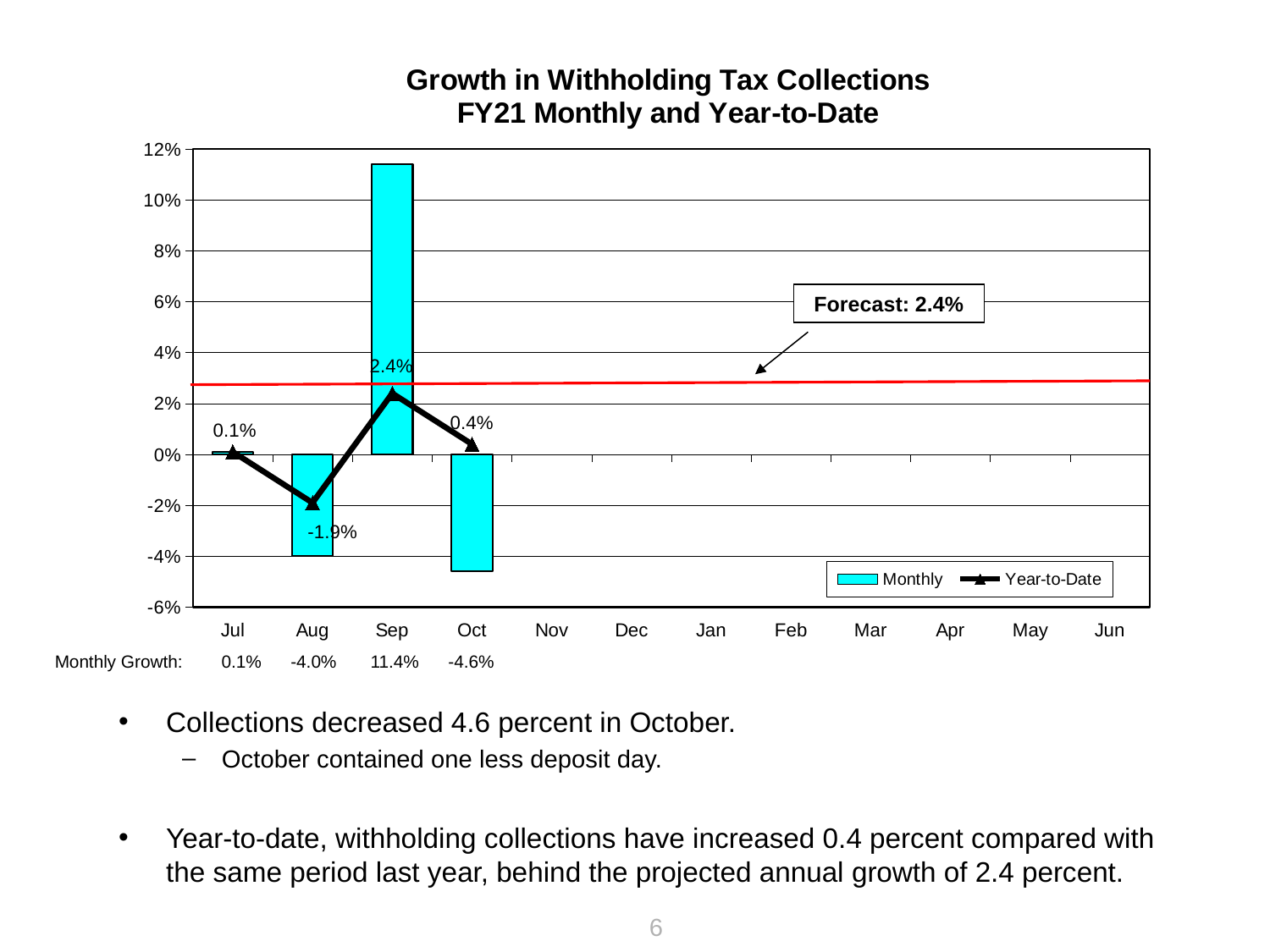
What is the Monthly growth value for Oct? -4.6% Which month has the lowest Monthly growth value? Oct How many series does the legend list? 2 What is the Year-to-Date value for Aug? -1.9% Which month has the highest Monthly growth value? Sep What is the Year-to-Date value for Oct? 0.4% Is the Monthly growth value for Sep greater or less than 10%? greater What is the title of the chart? Growth in Withholding Tax Collections FY21 Monthly and Year-to-Date What is the difference between the Monthly growth values for Sep and Oct? 16.0% Which is larger, the Year-to-Date value for Sep or the Year-to-Date value for Oct? Sep What forecast value is shown on the chart? 2.4% What is the Monthly growth value for Sep? 11.4%